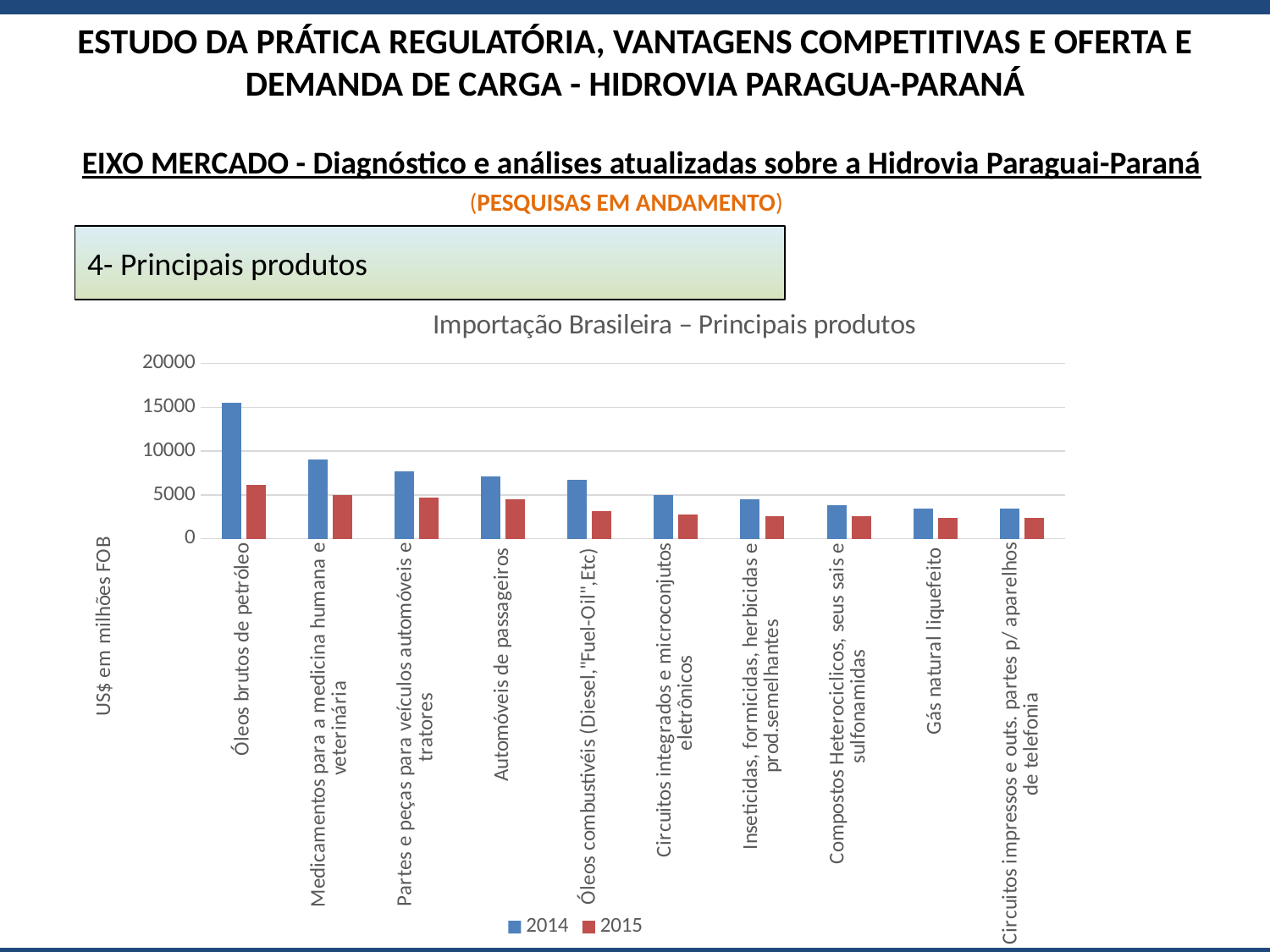
Is the 2014 value for Medicamentos para a medicina humana e veterinária greater or less than 10000? less Is the 2014 value for Óleos brutos de petróleo greater or less than 10000? greater For Automóveis de passageiros, which year has the larger import value, 2014 or 2015? 2014 Which product has the highest 2015 import value in the chart? Óleos brutos de petróleo How many product categories are shown on the x axis of the chart? 10 Do the 2014 values generally rise or fall moving from left to right along the x axis? Fall Is the 2015 value for Óleos combustíveis (Diesel, "Fuel-Oil", Etc) greater or less than 5000? less What kind of chart is shown on the slide? Bar chart What is the title of the chart? Importação Brasileira – Principais produtos Which product has the highest 2014 import value in the chart? Óleos brutos de petróleo How many series does the chart legend list? 2 What unit is given on the vertical axis label of the chart? US$ em milhões FOB